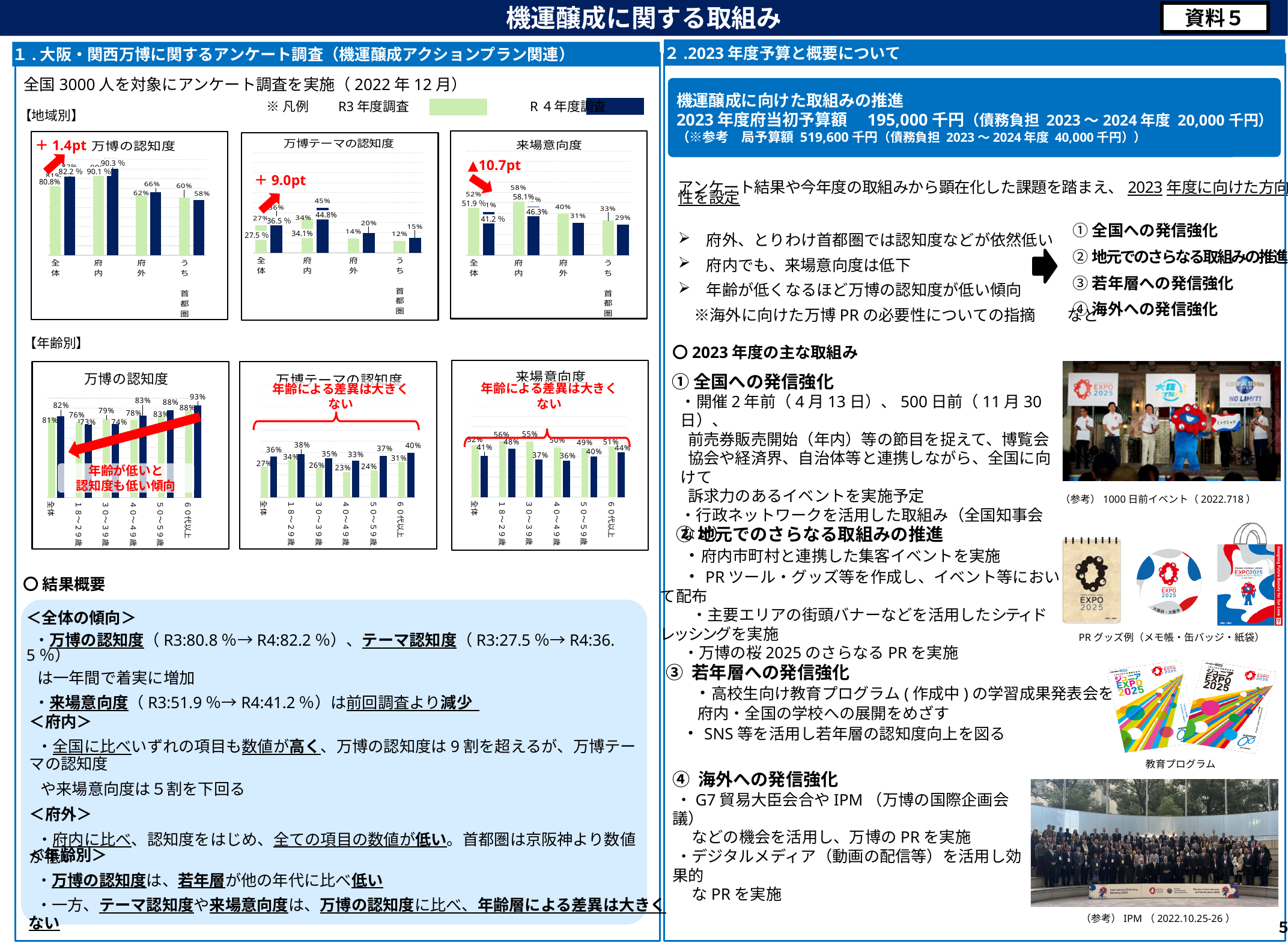
In the 【年齢別】 来場意向度 chart, what is the R3年度調査 value for 30~39歳? 55% In the 【年齢別】 万博の認知度 chart, what is the R4年度調査 value for 18~29歳? 73% How many survey series does the legend list for the charts? 2 What type of chart is the 【地域別】 万博の認知度 chart? Bar chart In the 【地域別】 万博の認知度 chart, what is the R4年度調査 value for 全体? 82.2% In the 【地域別】 万博テーマの認知度 chart, what is the R3年度調査 value for 全体? 27.5% In the 【地域別】 万博テーマの認知度 chart, which region has the lowest R4年度調査 value? うち首都圏 In the 【地域別】 来場意向度 chart, what is the difference between the R3年度調査 and R4年度調査 values for 全体 (51.9% and 41.2%)? 10.7pt How many age categories are shown in the 【年齢別】 万博テーマの認知度 chart? 6 In the 【年齢別】 万博の認知度 chart, which age group has the highest R4年度調査 value? 60代以上 In the 【地域別】 来場意向度 chart, what is the R4年度調査 value for 府内? 46.3% In the 【年齢別】 来場意向度 chart, which is larger for 40~49歳: the R3年度調査 value or the R4年度調査 value? R3年度調査